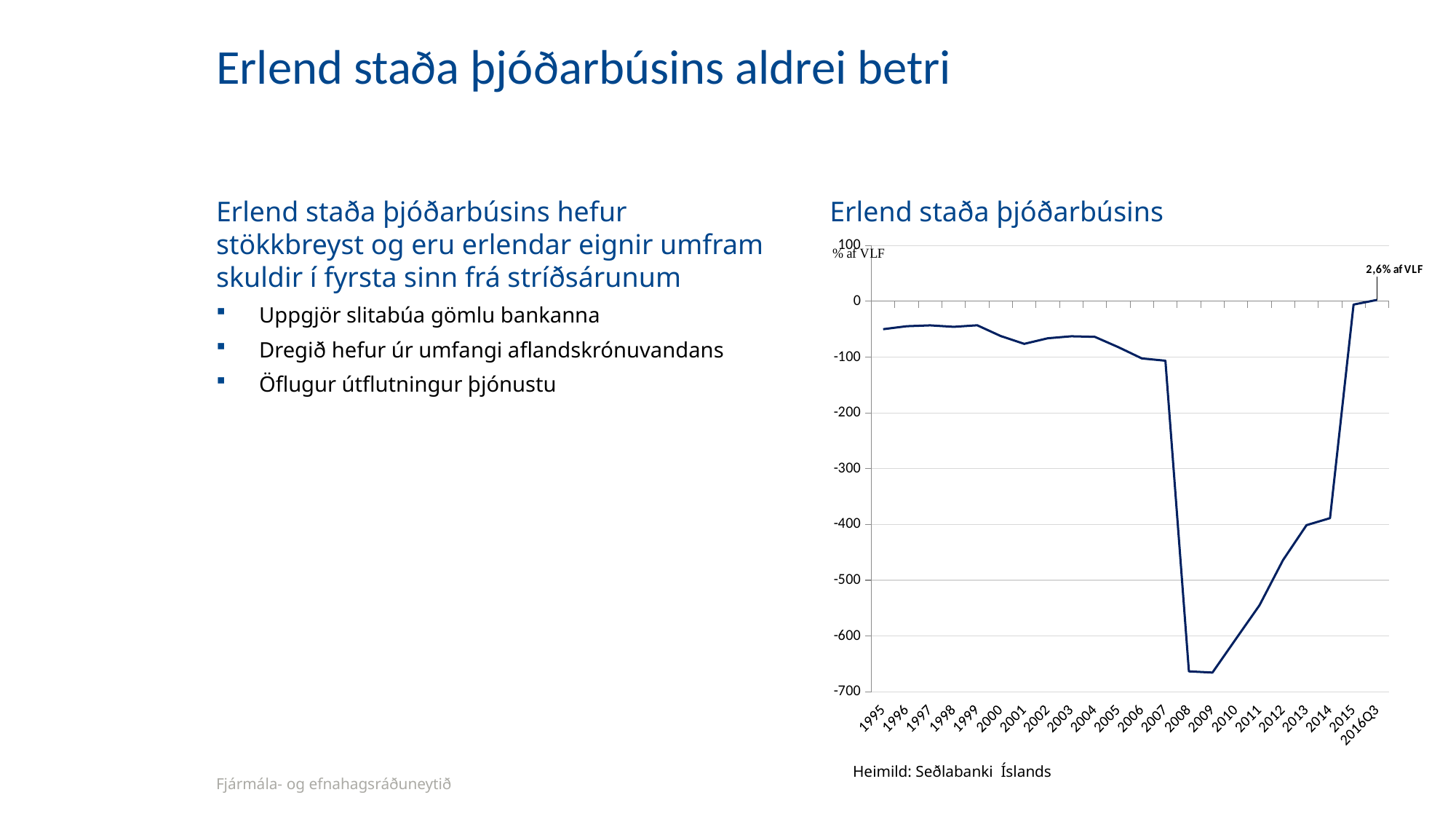
How many points are plotted along the x axis of the chart? 22 What kind of chart is shown on the slide? line chart Which point on the x axis has the highest value in the chart? 2016Q3 Is the value for 2015 greater or less than -100? greater Is the value for 2011 greater or less than -500? less What is the value for 2016Q3 in the chart 'Erlend staða þjóðarbúsins'? 2,6% af VLF Is the value for 2001 greater or less than -100? greater Do the values rise or fall from 2009 to 2015? rise What is the title of the chart? Erlend staða þjóðarbúsins What unit is shown on the y axis of the chart? % af VLF Which is larger, the value for 2008 or the value for 2015? 2015